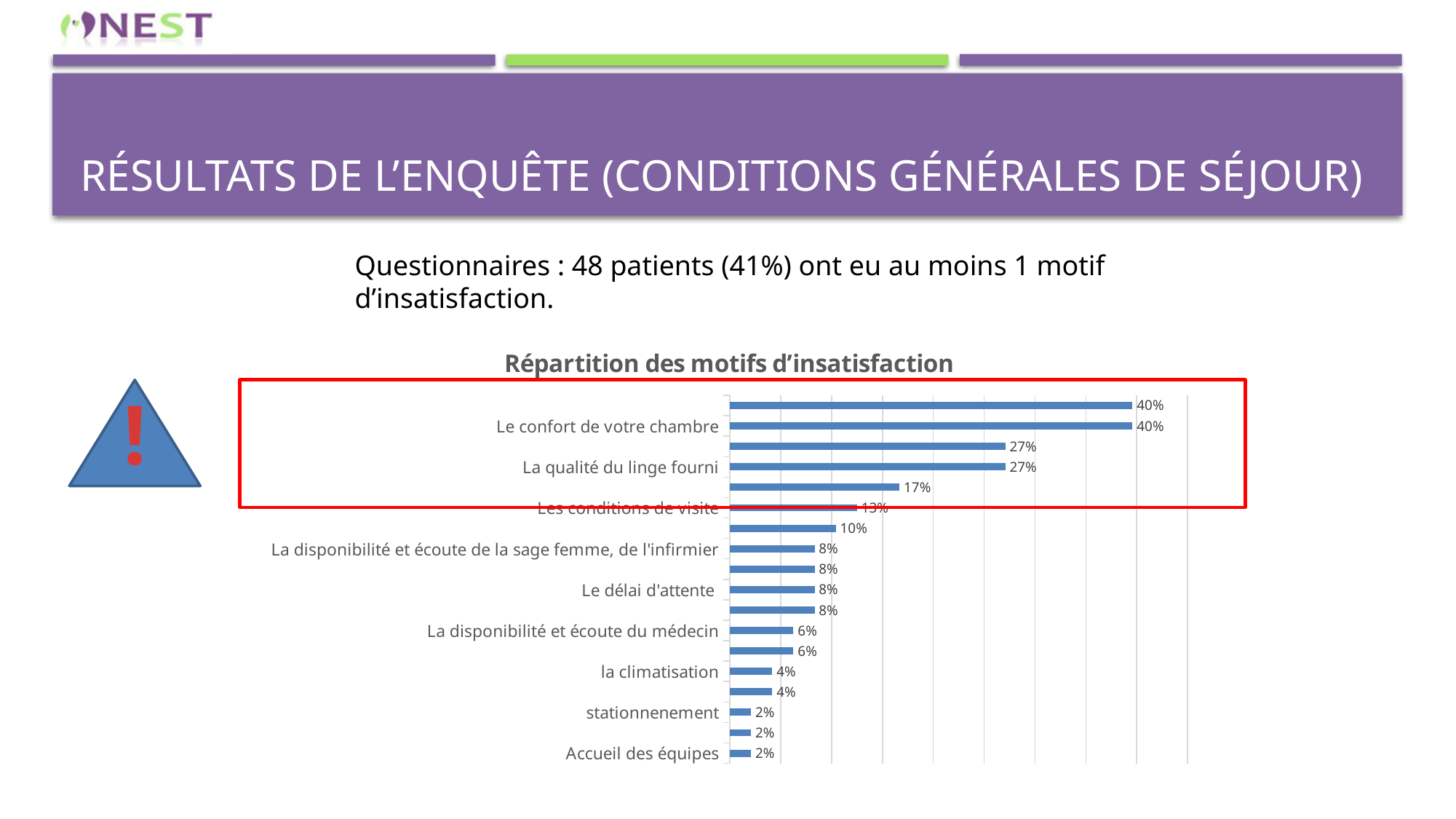
What is the highest value shown in the chart? 40% What is the value for 'Les conditions de visite'? 13% Which is larger, the value for 'La disponibilité et écoute du médecin' or the value for 'la climatisation'? La disponibilité et écoute du médecin What is the difference between the values for 'Le confort de votre chambre' and 'La qualité du linge fourni'? 13 percentage points What is the value for 'Le délai d'attente'? 8% What type of chart is shown on the slide? Bar chart What is the title of the chart? Répartition des motifs d'insatisfaction What is the value for 'Accueil des équipes'? 2% What is the value for 'la climatisation'? 4% What is the value for 'La qualité du linge fourni'? 27% What is the lowest value shown in the chart? 2% What is the value for 'Le confort de votre chambre'? 40%